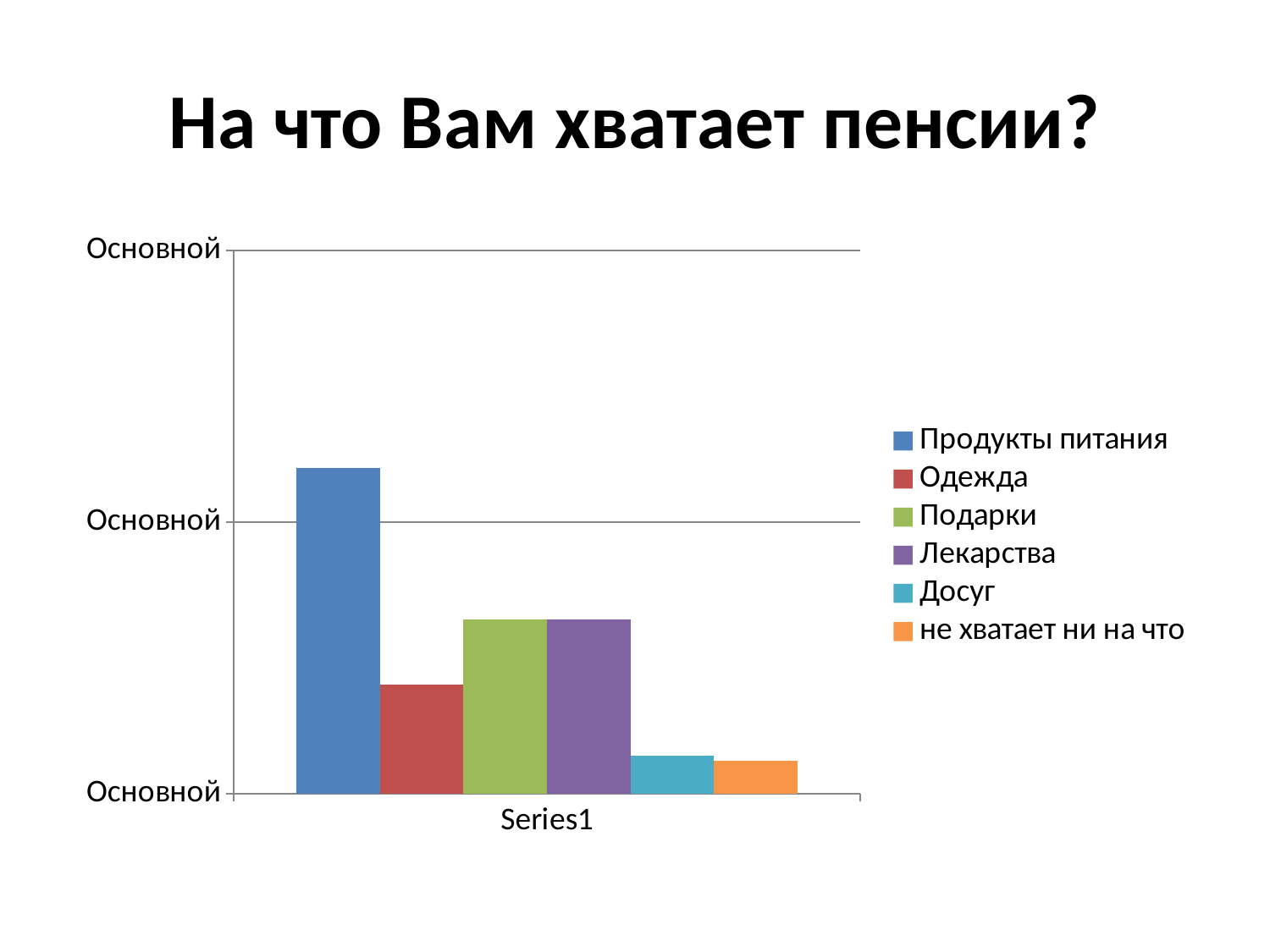
How many bars are plotted in the chart? 6 Which is larger, the bar for Одежда or the bar for Подарки? Подарки Which is larger, the bar for Продукты питания or the bar for Одежда? Продукты питания Which category has the highest bar in the chart? Продукты питания Which is larger, the bar for Продукты питания or the bar for Лекарства? Продукты питания What colour is the bar for Продукты питания in the chart? blue How many entries does the chart's legend list? 6 What is the title of the chart on the slide? На что Вам хватает пенсии? What type of chart is shown on the slide? bar chart